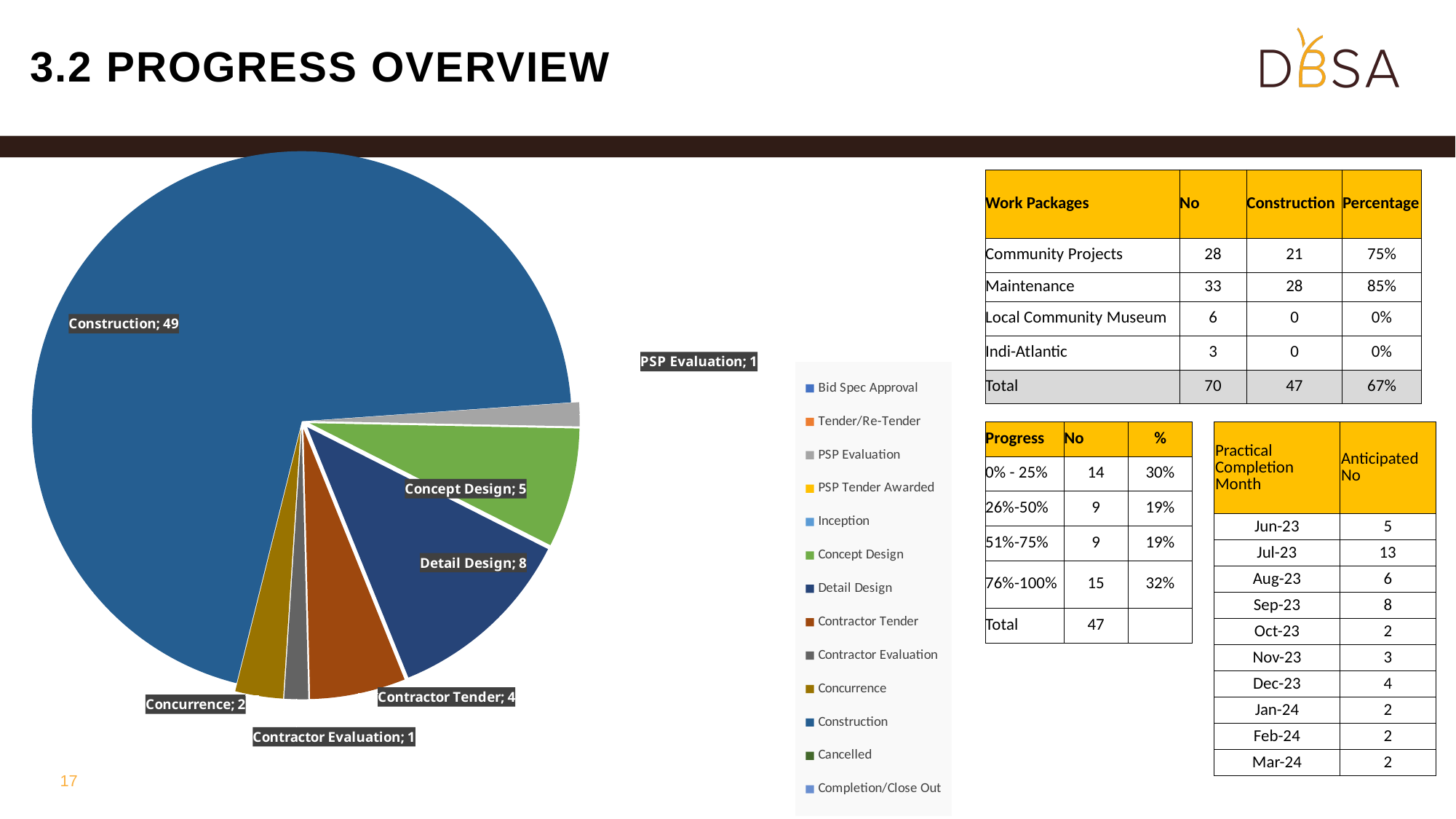
What is the value for Concept Design in the pie chart? 5 How many entries does the pie chart's legend list? 13 What is the value for Detail Design in the pie chart? 8 What is the value for Contractor Tender in the pie chart? 4 How many slices have data labels in the pie chart? 7 What is the difference between the values for Construction and Detail Design? 41 What is the total of all labelled slice values in the pie chart? 70 What type of chart is shown on the slide? Pie chart Which category has the largest slice in the pie chart? Construction What is the value for Concurrence in the pie chart? 2 Which is larger in the pie chart, Concept Design or Contractor Tender? Concept Design What is the value for Construction in the pie chart? 49